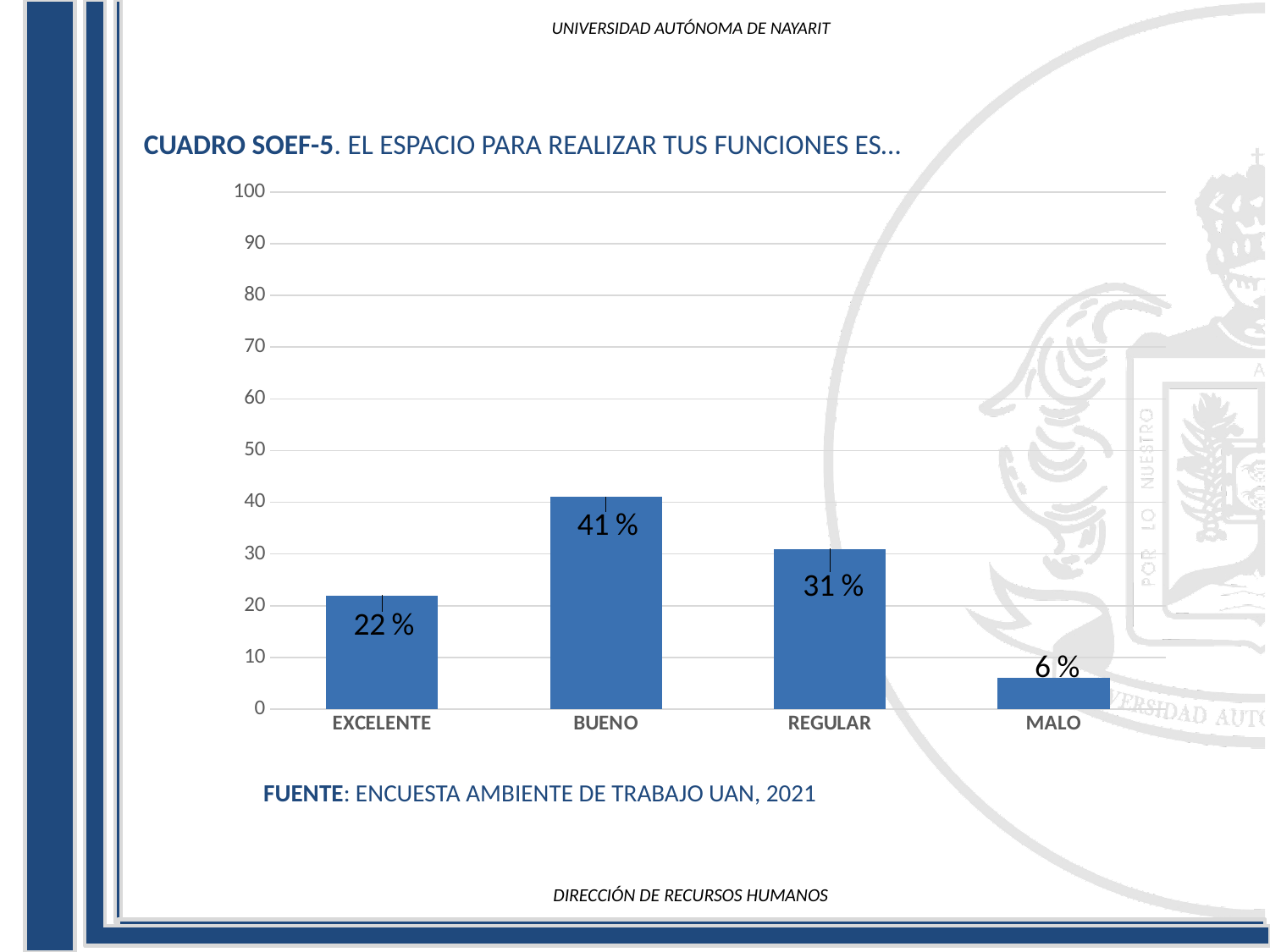
What is the value for BUENO? 41 % How many categories are shown on the x axis? 4 Which category has the highest value? BUENO What is the value for EXCELENTE? 22 % Which category has the lowest value? MALO Is the value for REGULAR greater or less than 40? less Which is larger, the value for EXCELENTE or the value for REGULAR? REGULAR What is the source cited below the chart? ENCUESTA AMBIENTE DE TRABAJO UAN, 2021 What is the difference between the values for BUENO and REGULAR? 10 % What is the value for REGULAR? 31 % What is the value for MALO? 6 % What kind of chart is shown on the slide? bar chart